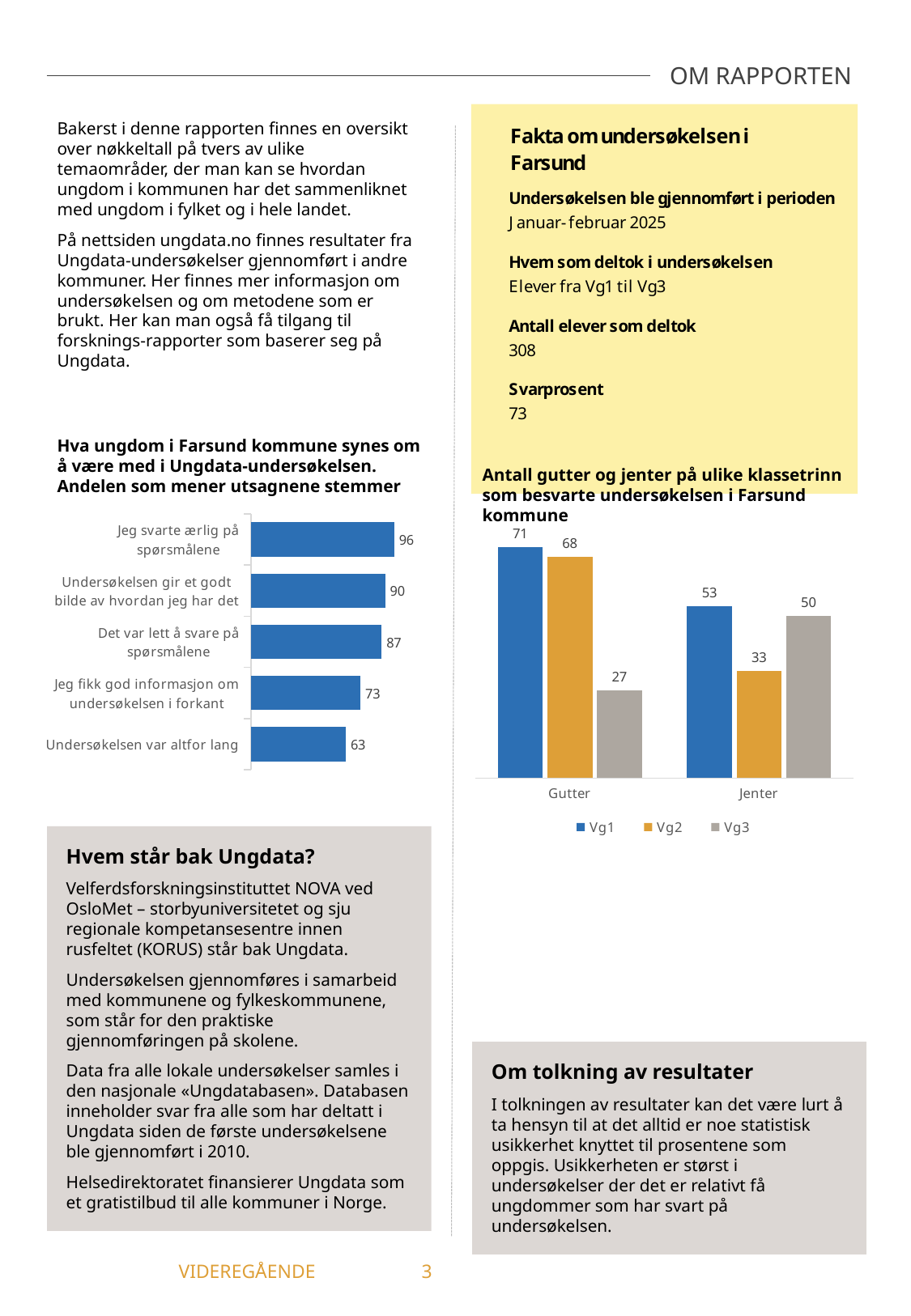
In the right chart 'Antall gutter og jenter på ulike klassetrinn som besvarte undersøkelsen i Farsund kommune', which group and class level has the highest value? Gutter, Vg1 In the right chart 'Antall gutter og jenter på ulike klassetrinn som besvarte undersøkelsen i Farsund kommune', what is the value for Vg1 among Jenter? 53 In the left chart 'Hva ungdom i Farsund kommune synes om å være med i Ungdata-undersøkelsen', what is the difference between 'Undersøkelsen gir et godt bilde av hvordan jeg har det' and 'Jeg fikk god informasjon om undersøkelsen i forkant'? 17 In the right chart 'Antall gutter og jenter på ulike klassetrinn som besvarte undersøkelsen i Farsund kommune', what is the value for Vg3 among Gutter? 27 In the right chart 'Antall gutter og jenter på ulike klassetrinn som besvarte undersøkelsen i Farsund kommune', how many series does the legend list? 3 What kind of chart is the left chart 'Hva ungdom i Farsund kommune synes om å være med i Ungdata-undersøkelsen'? Bar chart In the right chart 'Antall gutter og jenter på ulike klassetrinn som besvarte undersøkelsen i Farsund kommune', which is larger: Vg2 for Gutter or Vg2 for Jenter? Vg2 for Gutter In the left chart 'Hva ungdom i Farsund kommune synes om å være med i Ungdata-undersøkelsen', which statement has the lowest value? Undersøkelsen var altfor lang In the right chart 'Antall gutter og jenter på ulike klassetrinn som besvarte undersøkelsen i Farsund kommune', what is the total number of Gutter across Vg1, Vg2 and Vg3? 166 In the left chart 'Hva ungdom i Farsund kommune synes om å være med i Ungdata-undersøkelsen', what is the value for 'Jeg svarte ærlig på spørsmålene'? 96 In the left chart 'Hva ungdom i Farsund kommune synes om å være med i Ungdata-undersøkelsen', how many statements (bars) are shown? 5 In the right chart 'Antall gutter og jenter på ulike klassetrinn som besvarte undersøkelsen i Farsund kommune', what colour are the Vg2 bars? Orange